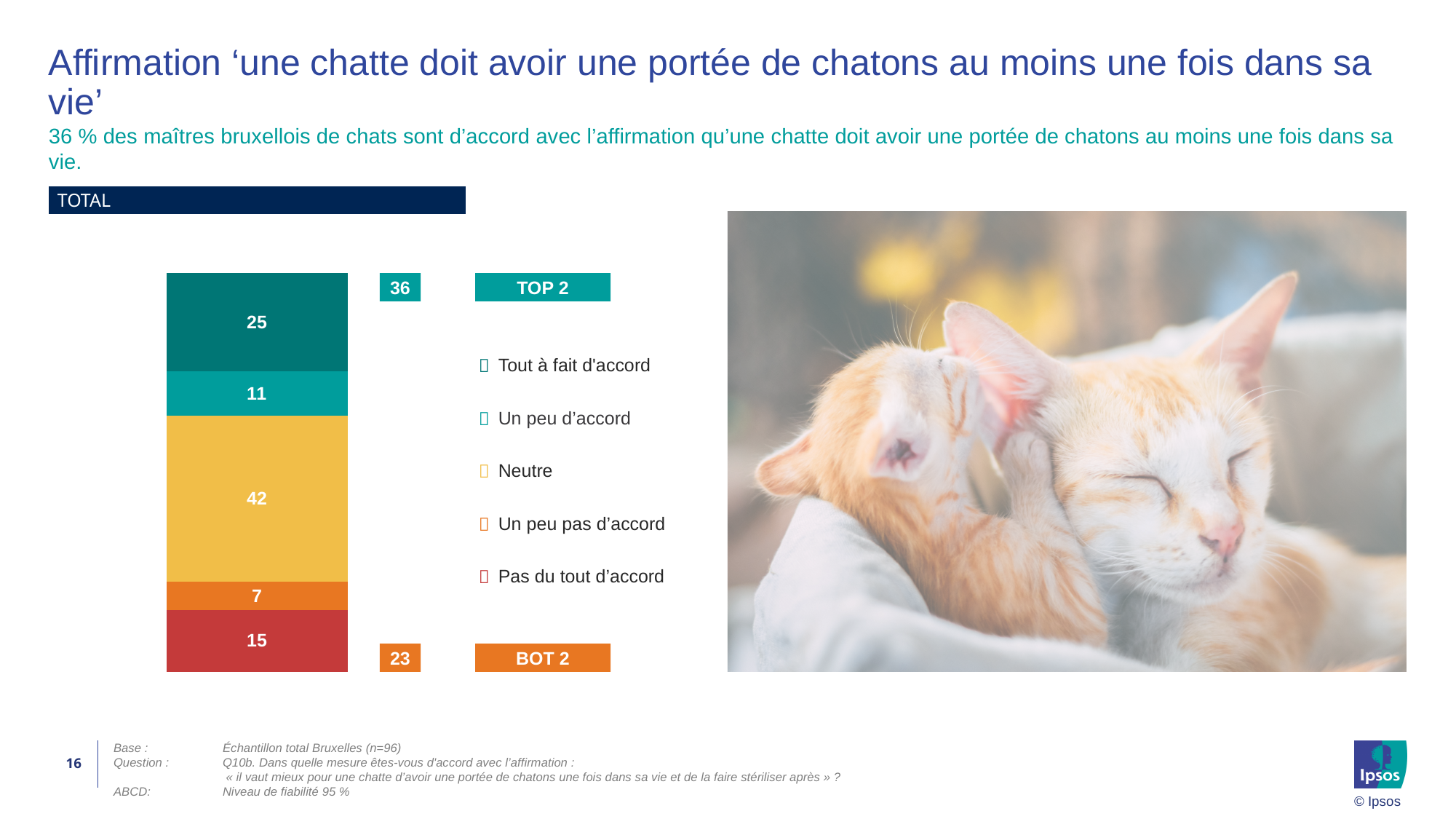
Which response category has the highest value in the stacked bar? Neutre What is the TOP 2 value shown next to the bar? 36 Which is larger, the value for 'Un peu d'accord' or the value for 'Pas du tout d'accord'? Pas du tout d'accord What is the value for 'Tout à fait d'accord' in the stacked bar? 25 What is the BOT 2 value shown next to the bar? 23 What is the difference between the 'Neutre' value and the 'Tout à fait d'accord' value? 17 How many response categories does the legend list? 5 What kind of chart is shown on the slide? Stacked bar chart What is the value for 'Pas du tout d'accord' in the stacked bar? 15 What is the value for 'Un peu pas d'accord' in the stacked bar? 7 Which response category has the lowest value in the stacked bar? Un peu pas d'accord What is the value for 'Neutre' in the stacked bar? 42